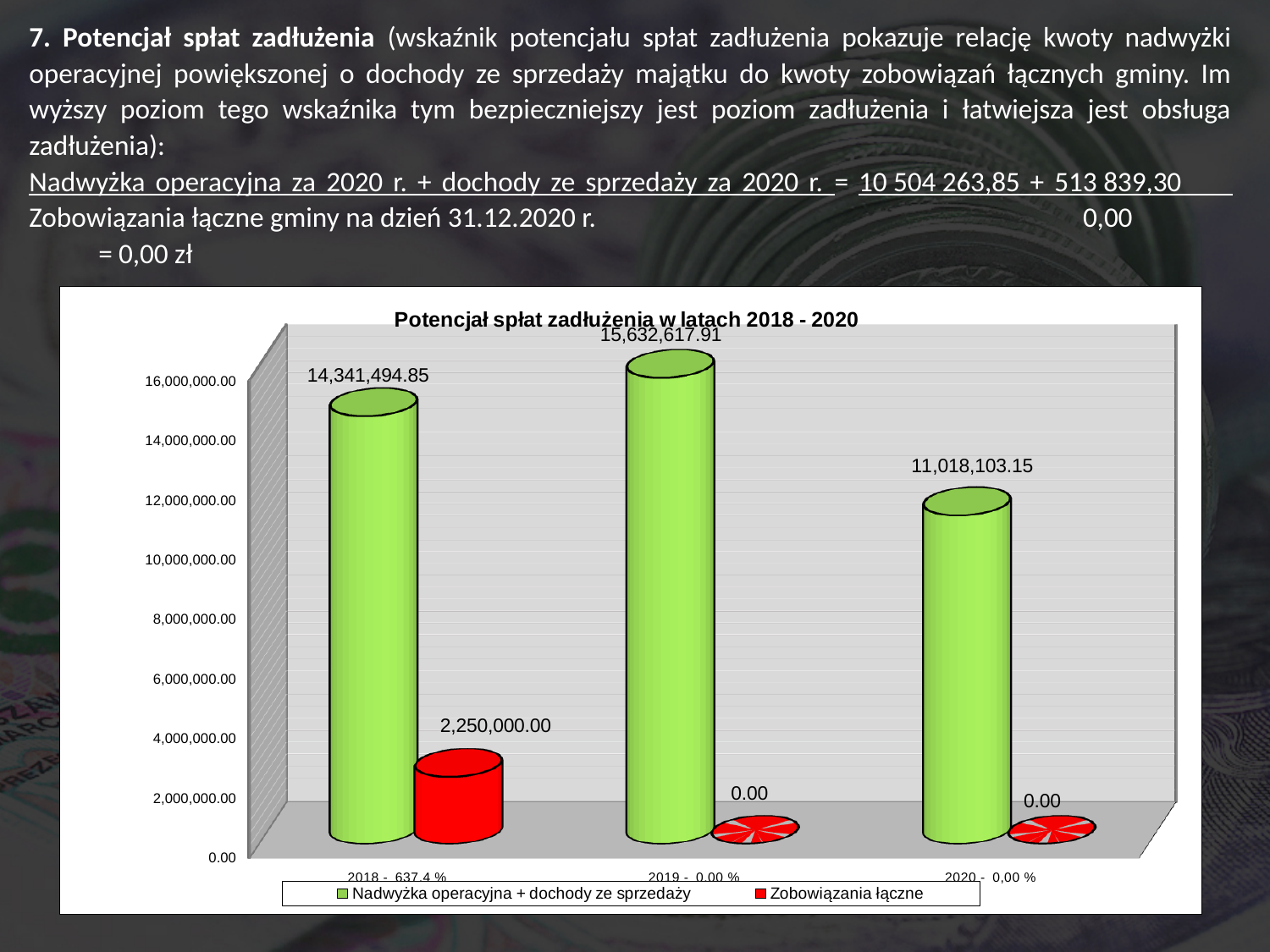
What is the difference between the Nadwyżka operacyjna + dochody ze sprzedaży values for 2019 and 2018? 1,291,123.06 How many series does the legend list? 2 What is the value of Zobowiązania łączne for 2018? 2,250,000.00 What is the value of Nadwyżka operacyjna + dochody ze sprzedaży for 2019? 15,632,617.91 Which year has the lowest value of Nadwyżka operacyjna + dochody ze sprzedaży? 2020 What is the difference between Nadwyżka operacyjna + dochody ze sprzedaży and Zobowiązania łączne in 2018? 12,091,494.85 Which is larger in 2018: Nadwyżka operacyjna + dochody ze sprzedaży or Zobowiązania łączne? Nadwyżka operacyjna + dochody ze sprzedaży What kind of chart is shown on the slide? Bar chart How many years are shown on the x axis of the chart? 3 What is the title of the chart? Potencjał spłat zadłużenia w latach 2018 - 2020 Which year has the highest value of Nadwyżka operacyjna + dochody ze sprzedaży? 2019 What is the value of Nadwyżka operacyjna + dochody ze sprzedaży for 2020? 11,018,103.15